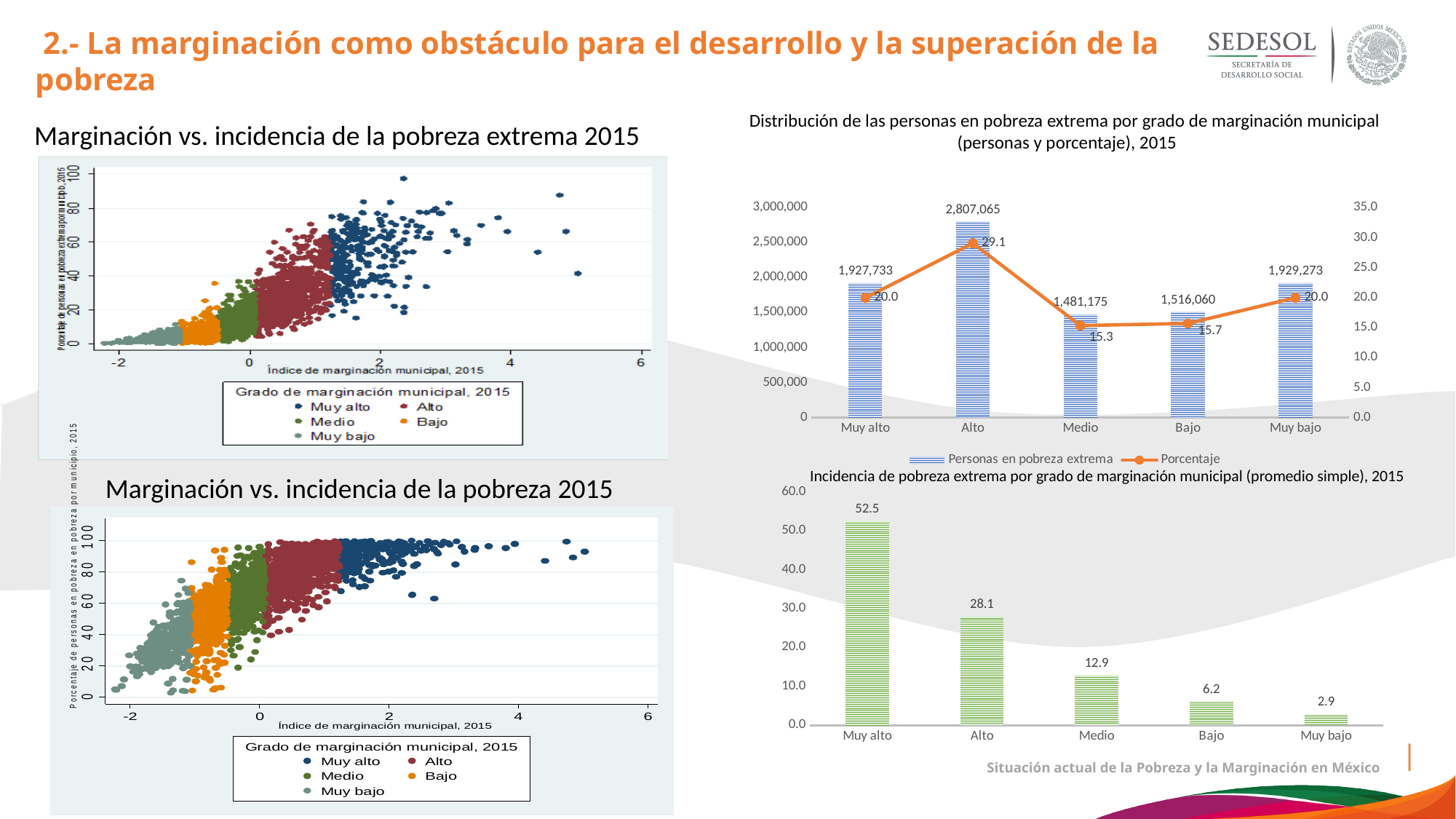
In the chart 'Distribución de las personas en pobreza extrema por grado de marginación municipal', which category has the lowest number of people in extreme poverty? Medio In the chart 'Distribución de las personas en pobreza extrema por grado de marginación municipal', how many people in extreme poverty are in the 'Alto' category? 2,807,065 In the chart 'Incidencia de pobreza extrema por grado de marginación municipal (promedio simple), 2015', what is the value for 'Muy alto'? 52.5 What kind of chart is 'Marginación vs. incidencia de la pobreza extrema 2015' on the left of the slide? scatter plot In the chart 'Incidencia de pobreza extrema por grado de marginación municipal (promedio simple), 2015', what is the value for 'Bajo'? 6.2 In the chart 'Incidencia de pobreza extrema por grado de marginación municipal (promedio simple), 2015', what is the difference between 'Alto' and 'Medio'? 15.2 In the chart 'Incidencia de pobreza extrema por grado de marginación municipal (promedio simple), 2015', how many categories are shown on the x axis? 5 In the chart 'Distribución de las personas en pobreza extrema por grado de marginación municipal', what is the percentage value for 'Alto'? 29.1 In the chart 'Distribución de las personas en pobreza extrema por grado de marginación municipal', which category has the highest number of people in extreme poverty? Alto In the chart 'Incidencia de pobreza extrema por grado de marginación municipal (promedio simple), 2015', do the values rise or fall from 'Muy alto' to 'Muy bajo'? fall In the chart 'Distribución de las personas en pobreza extrema por grado de marginación municipal', how many series does the legend list? 2 In the chart 'Distribución de las personas en pobreza extrema por grado de marginación municipal', what is the difference in people between 'Muy bajo' and 'Muy alto'? 1,540